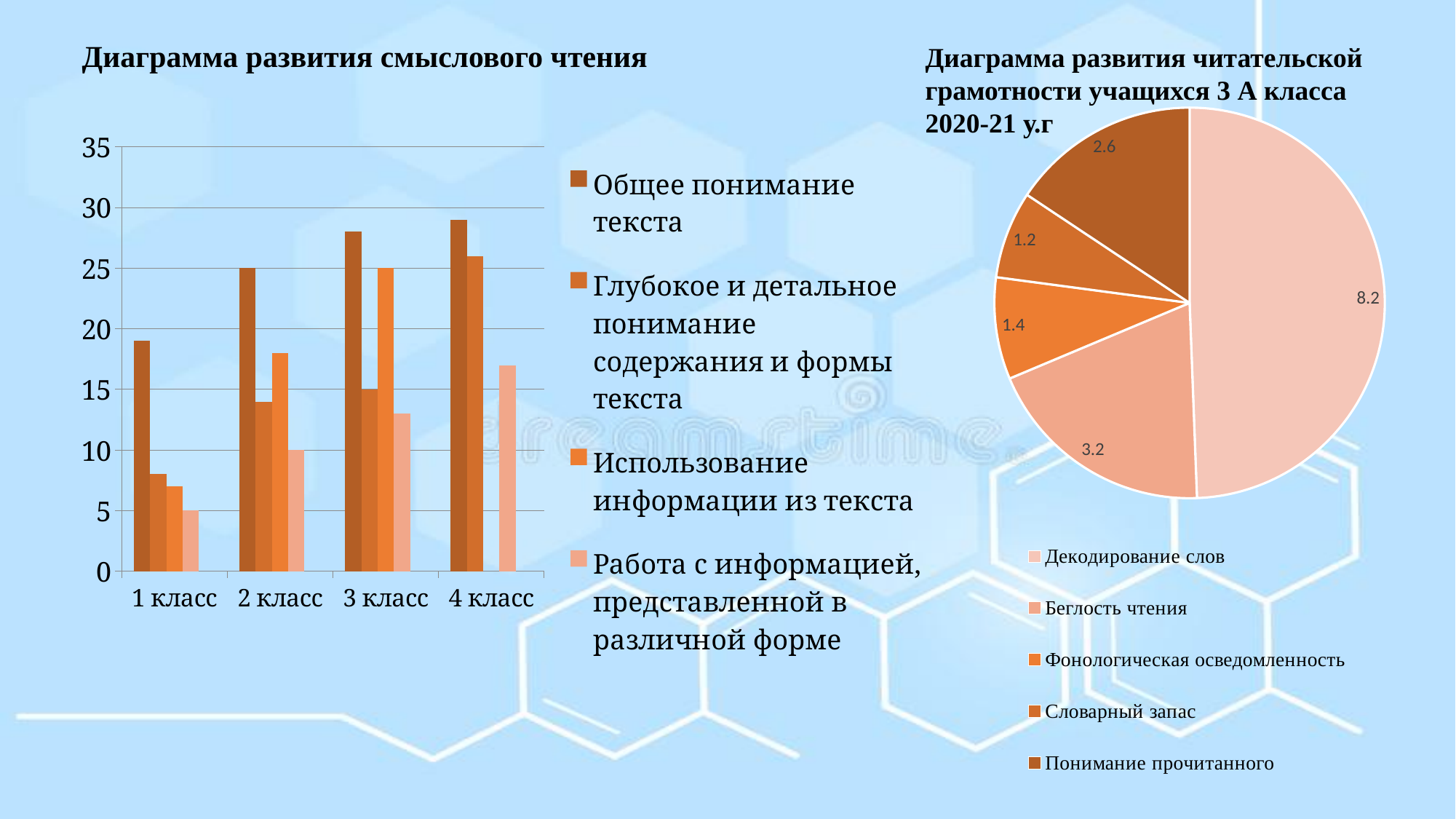
In the left bar chart, is the value for 'Работа с информацией, представленной в различной форме' in '4 класс' greater or less than 15? greater In the left bar chart, is the value for 'Общее понимание текста' in '4 класс' greater or less than 25? greater In the right pie chart, what is the value for 'Декодирование слов'? 8.2 In the right pie chart, what is the difference between 'Декодирование слов' and 'Беглость чтения'? 5.0 In the right pie chart, which is larger: 'Понимание прочитанного' or 'Фонологическая осведомленность'? Понимание прочитанного In the right pie chart, which category has the smallest value? Словарный запас In the left bar chart, how many series does the legend list? 4 In the left bar chart, does the value for 'Общее понимание текста' rise or fall from '1 класс' to '4 класс'? rise What kind of chart is the right chart, 'Диаграмма развития читательской грамотности учащихся 3 А класса 2020-21 у.г'? pie chart What kind of chart is the left chart, 'Диаграмма развития смыслового чтения'? bar chart In the left bar chart, is the value for 'Общее понимание текста' in '1 класс' greater or less than 15? greater In the left bar chart, how many categories are shown on the x axis? 4